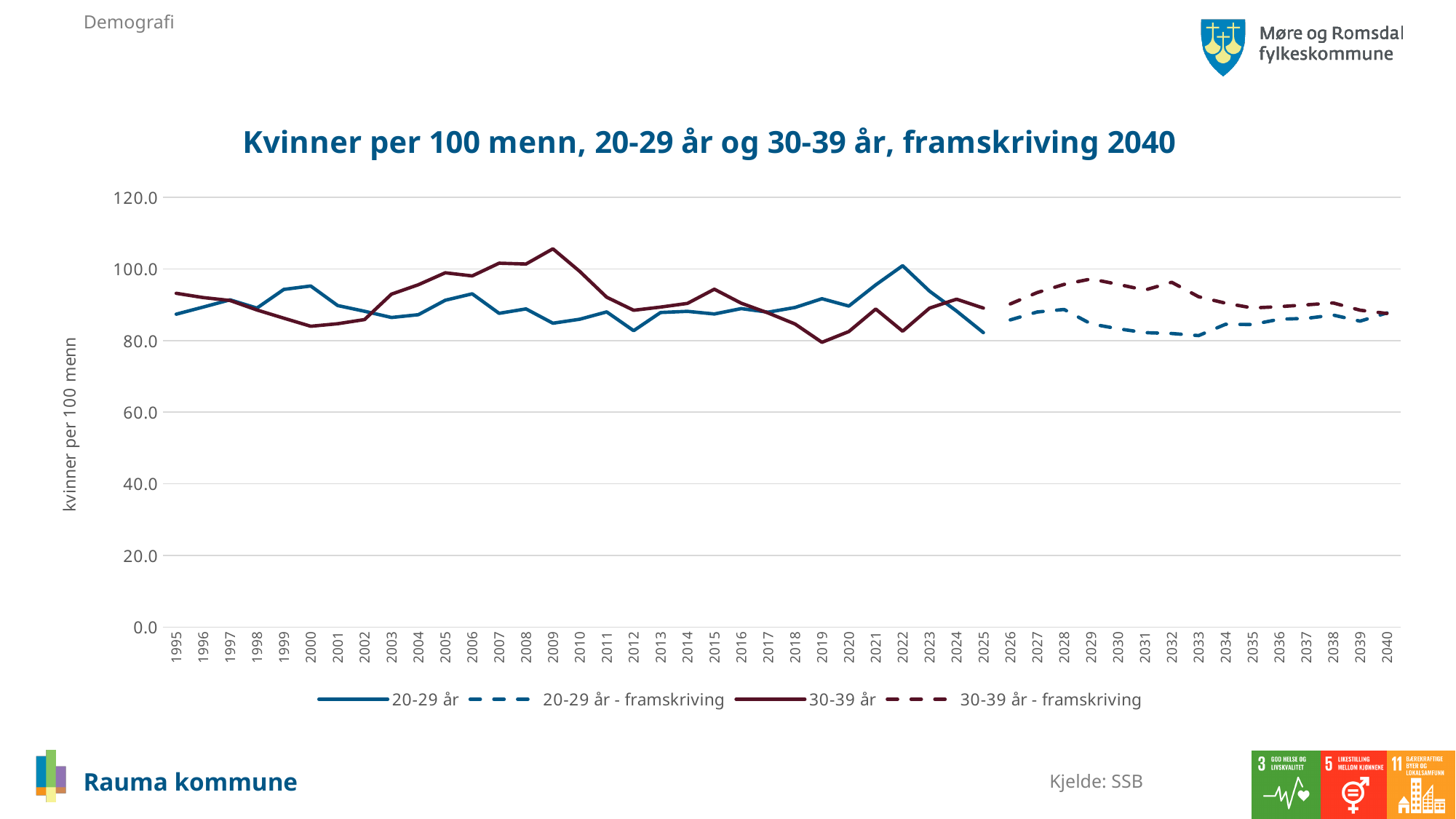
In which year does the 20-29 år series reach its highest value? 2022 What is the title of the chart? Kvinner per 100 menn, 20-29 år og 30-39 år, framskriving 2040 What is the label on the vertical axis? kvinner per 100 menn How many series does the legend list? 4 In which year does the 30-39 år series reach its highest value? 2009 Is the value for 30-39 år - framskriving in 2029 greater or less than 100? less Is the value for 30-39 år in 2009 greater or less than 100? greater In 2009, which series has the larger value, 20-29 år or 30-39 år? 30-39 år In 2022, which series has the larger value, 20-29 år or 30-39 år? 20-29 år Does the 30-39 år series rise or fall from 2009 to 2012? fall In which year does the 30-39 år series reach its lowest value? 2019 What kind of chart is shown on the slide? line chart